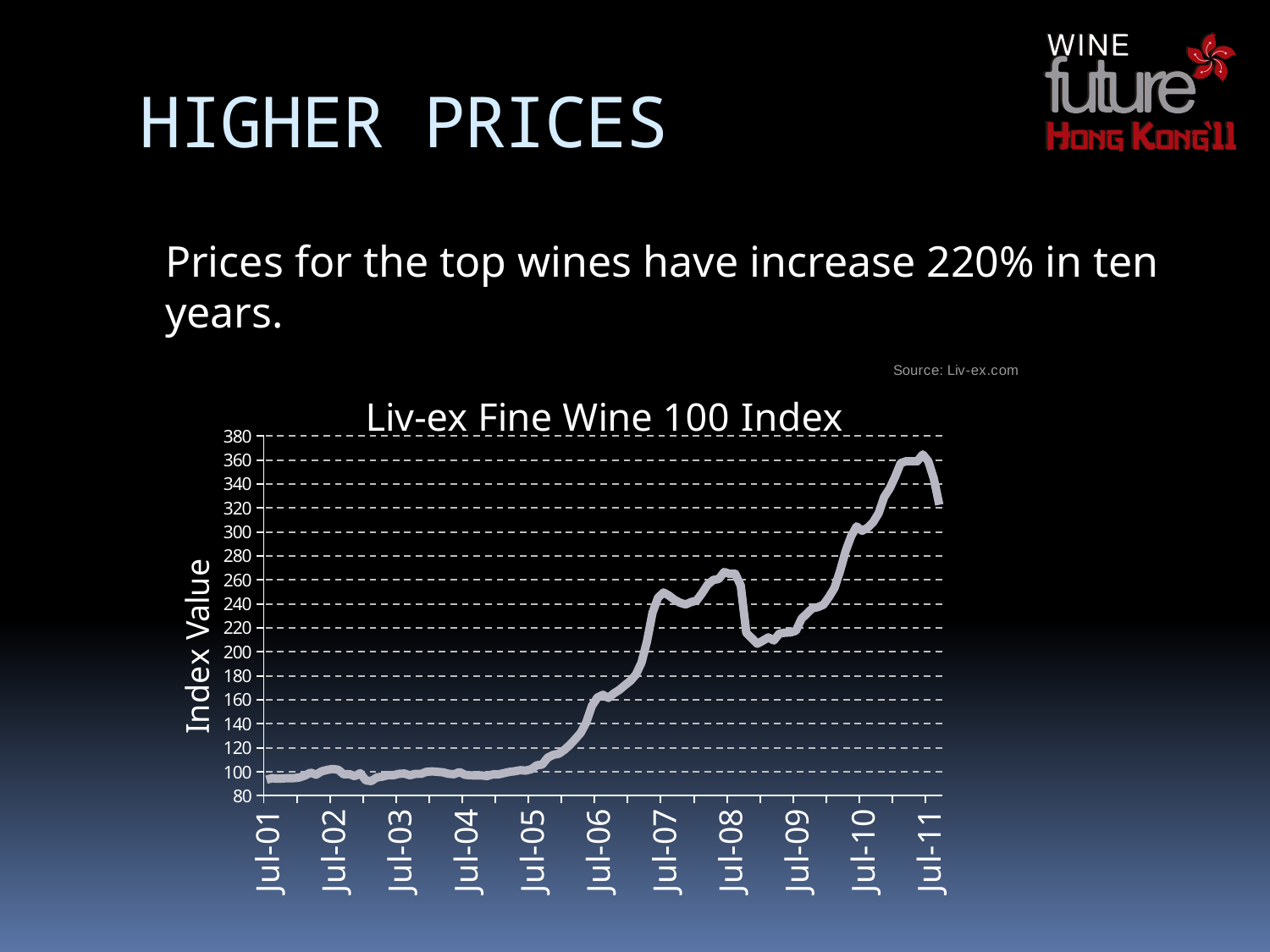
Is the index value at Jul-07 greater or less than 220? greater What is the title of the chart? Liv-ex Fine Wine 100 Index What is the label on the vertical axis of the chart? Index Value Is the highest point reached by the index greater or less than 340? greater What kind of chart is shown on the slide? line chart Overall, does the Liv-ex Fine Wine 100 Index rise or fall from Jul-01 to Jul-11? rise Which is larger, the index value at Jul-07 or at Jul-04? Jul-07 Is the index value at Jul-08 greater or less than 240? greater How many date labels are shown along the x axis of the chart? 11